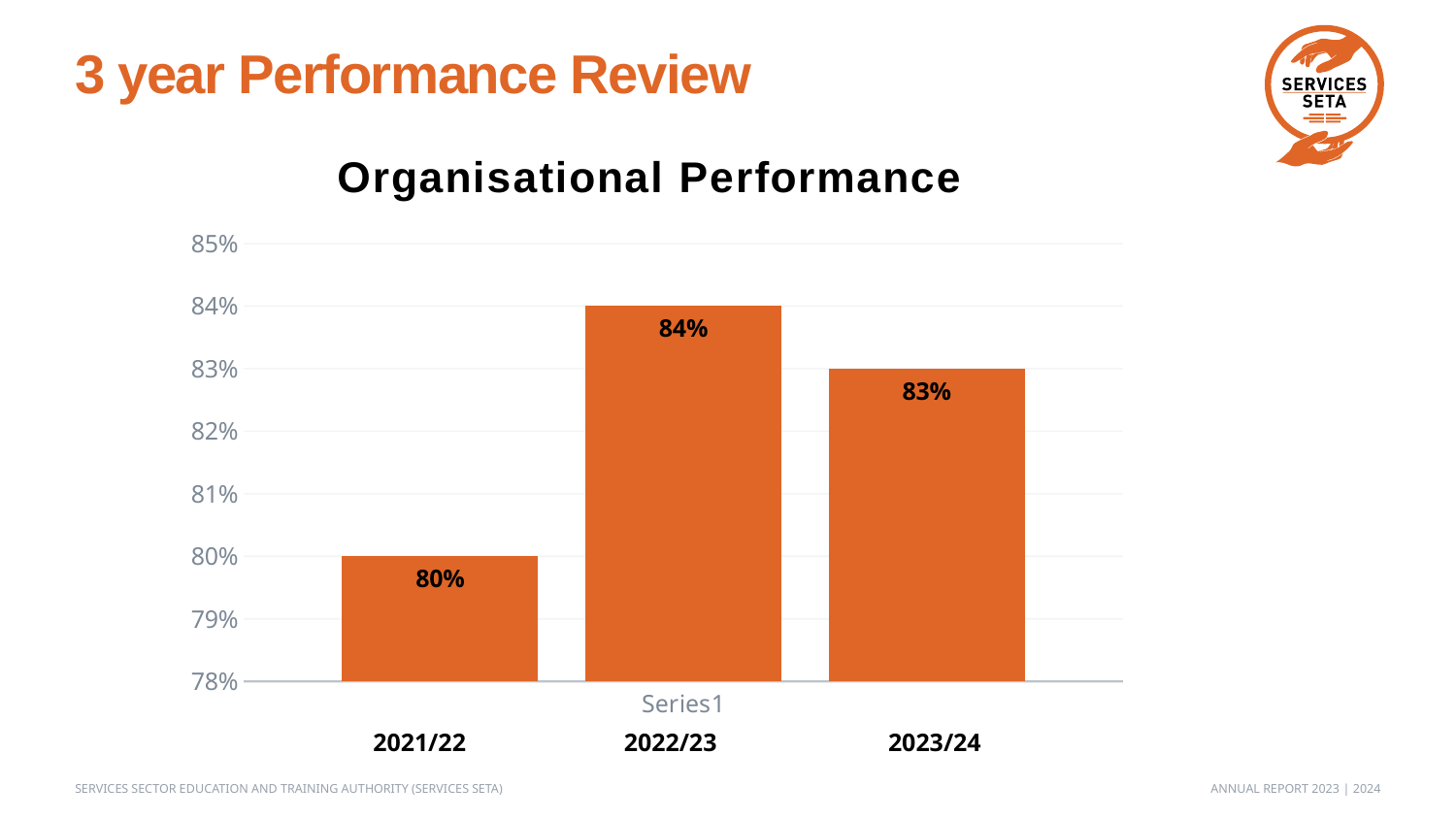
What is the organisational performance value for 2023/24? 83% What is the title of the chart? Organisational Performance Which year has the lowest organisational performance? 2021/22 Is the value for 2023/24 greater or less than 82%? greater What is the difference between the 2022/23 and 2021/22 values? 4% What is the organisational performance value for 2021/22? 80% Which is larger, the value for 2023/24 or the value for 2021/22? 2023/24 How many years are shown on the chart? 3 What is the difference between the 2022/23 and 2023/24 values? 1% Which year has the highest organisational performance? 2022/23 What is the organisational performance value for 2022/23? 84% What kind of chart is shown on the slide? Bar chart